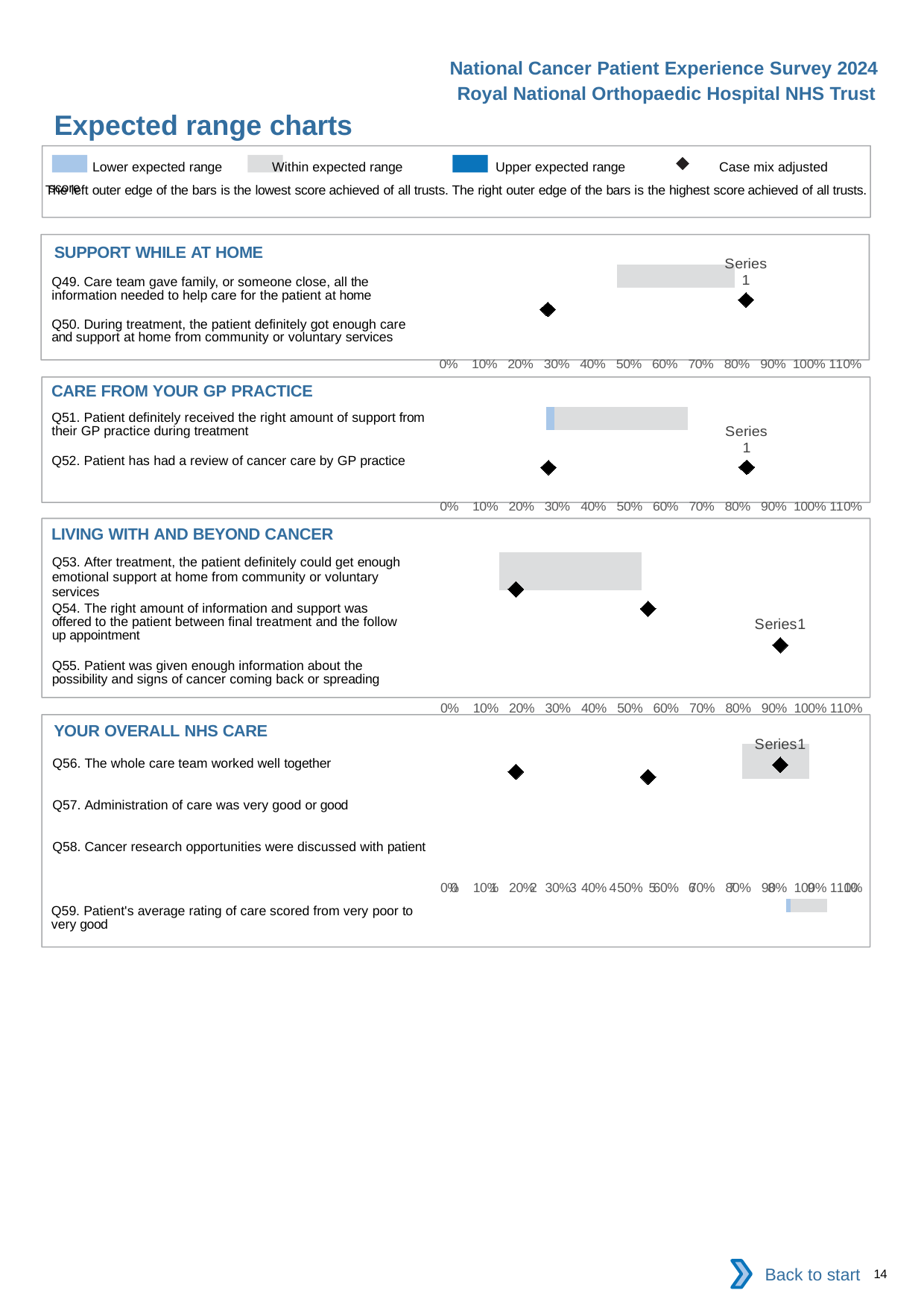
How many diamond markers are plotted in the LIVING WITH AND BEYOND CANCER chart? 3 In the SUPPORT WHILE AT HOME chart, is the leftmost diamond marker greater or less than 50%? less What kind of chart is used in the SUPPORT WHILE AT HOME section? bar chart In the SUPPORT WHILE AT HOME chart, is the rightmost diamond marker greater or less than 70%? greater How many section charts are shown on the slide? 4 How many entries does the legend at the top of the slide list? 4 How many questions are listed in the LIVING WITH AND BEYOND CANCER section? 3 In the LIVING WITH AND BEYOND CANCER chart, is the rightmost diamond marker greater or less than 80%? greater What is the highest tick label shown on the x axis of the charts? 110% According to the legend, what does the diamond marker represent? Case mix adjusted score